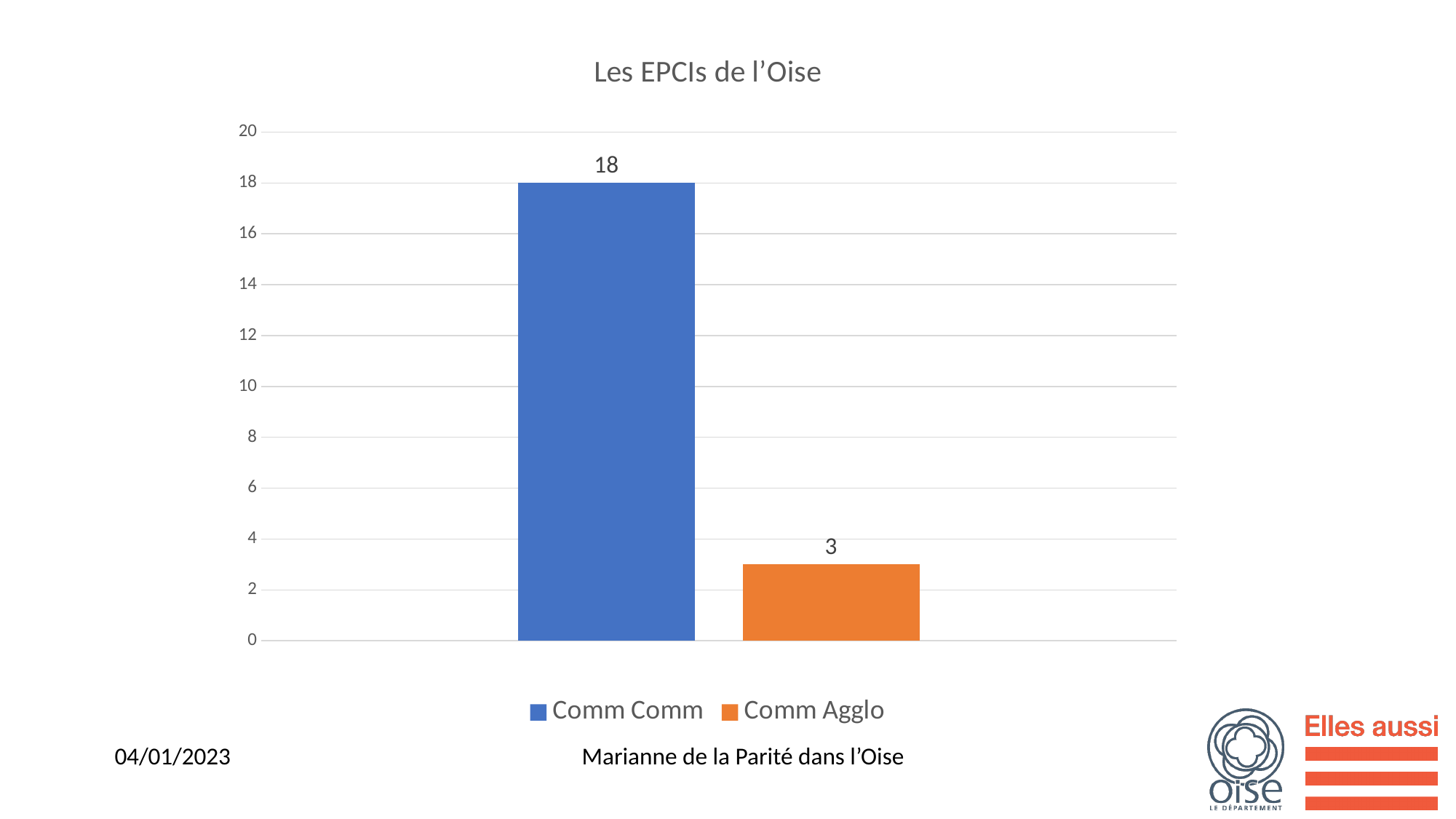
Which series has the lowest value? Comm Agglo What is the value for Comm Agglo? 3 What is the value for Comm Comm? 18 Which series has the highest value? Comm Comm Is the value for Comm Agglo greater or less than 4? less Is the value for Comm Comm greater or less than 10? greater What is the title of the chart? Les EPCIs de l’Oise What is the difference between the values for Comm Comm and Comm Agglo? 15 How many series does the legend list? 2 How many bars are plotted on the chart? 2 What kind of chart is shown on the slide? bar chart Which is larger, the value for Comm Comm or the value for Comm Agglo? Comm Comm